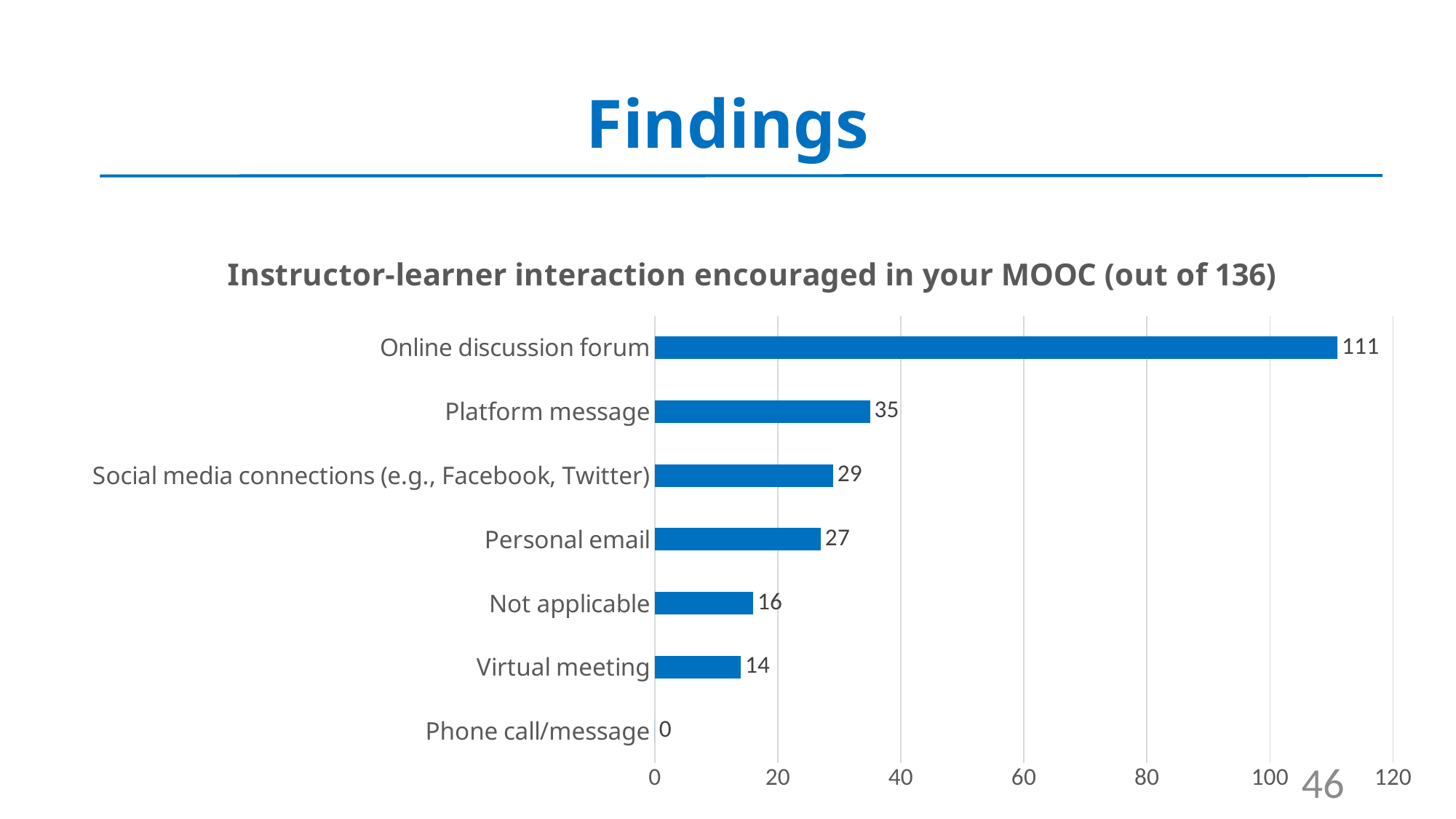
What is the difference between the values for Online discussion forum and Platform message? 76 What is the value for Online discussion forum? 111 What is the title of the chart? Instructor-learner interaction encouraged in your MOOC (out of 136) Which category has the highest value? Online discussion forum How many categories are shown in the chart? 7 What kind of chart is shown on the slide? Bar chart Which category has the lowest value? Phone call/message What is the difference between the values for Personal email and Virtual meeting? 13 What is the value for Social media connections (e.g., Facebook, Twitter)? 29 What is the value for Phone call/message? 0 What is the value for Platform message? 35 Which is larger, the value for Not applicable or the value for Virtual meeting? Not applicable